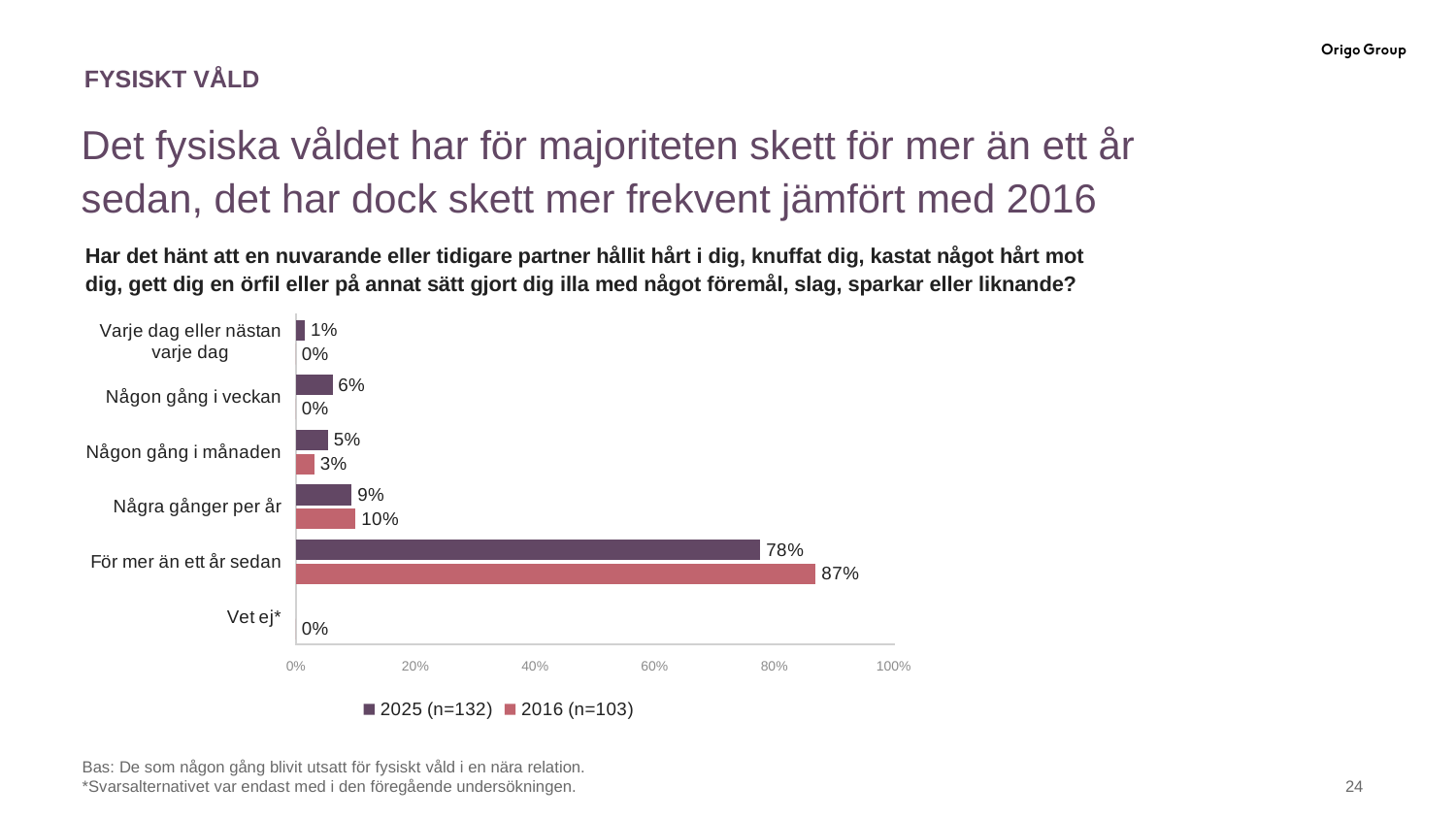
How many categories are shown on the y axis of the chart? 6 What is the value for "Varje dag eller nästan varje dag" in the 2016 (n=103) series? 0% What is the difference between the 2016 (n=103) and 2025 (n=132) values for "För mer än ett år sedan"? 9 percentage points Which category has the highest value in the 2025 (n=132) series? För mer än ett år sedan How many series does the legend list? 2 What is the value for "Några gånger per år" in the 2016 (n=103) series? 10% What is the value for "För mer än ett år sedan" in the 2025 (n=132) series? 78% What is the value for "För mer än ett år sedan" in the 2016 (n=103) series? 87% Is the 2016 (n=103) value for "För mer än ett år sedan" greater or less than 80%? greater What kind of chart is shown on the slide? Bar chart Which series has the larger value for "Någon gång i månaden", 2025 (n=132) or 2016 (n=103)? 2025 (n=132) What is the value for "Någon gång i veckan" in the 2025 (n=132) series? 6%